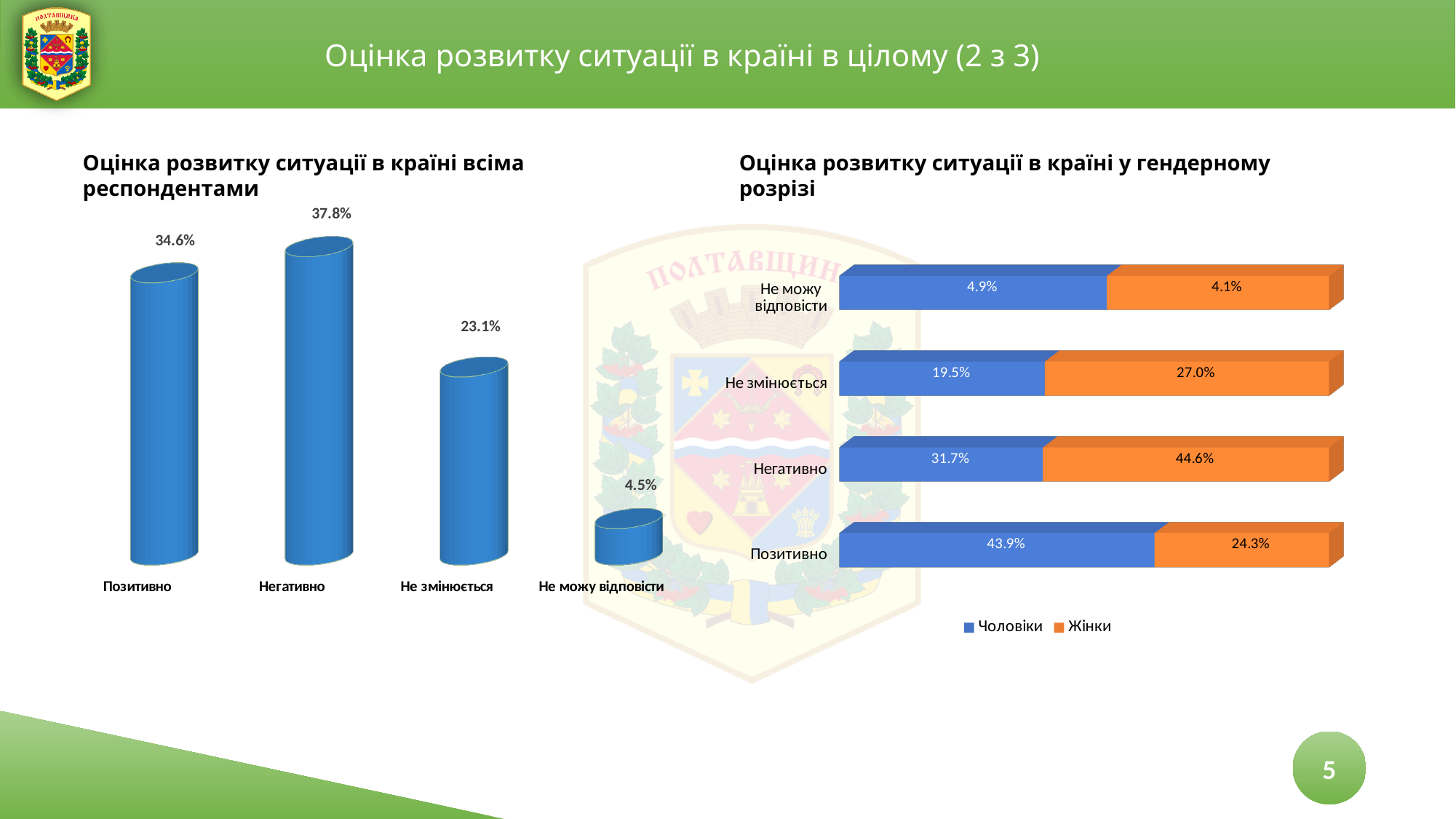
In the right chart (Оцінка розвитку ситуації в країні у гендерному розрізі), which is larger for Не змінюється: Чоловіки or Жінки? Жінки In the left chart (Оцінка розвитку ситуації в країні всіма респондентами), how many categories are shown? 4 What kind of chart is the left chart (Оцінка розвитку ситуації в країні всіма респондентами)? Bar chart In the left chart (Оцінка розвитку ситуації в країні всіма респондентами), what is the difference between Негативно and Позитивно? 3.2% In the right chart (Оцінка розвитку ситуації в країні у гендерному розрізі), what is the value for Жінки in the Негативно category? 44.6% In the left chart (Оцінка розвитку ситуації в країні всіма респондентами), what is the value for Негативно? 37.8% In the right chart (Оцінка розвитку ситуації в країні у гендерному розрізі), how many series does the legend list? 2 In the left chart (Оцінка розвитку ситуації в країні всіма респондентами), which category has the lowest value? Не можу відповісти In the left chart (Оцінка розвитку ситуації в країні всіма респондентами), which category has the highest value? Негативно In the right chart (Оцінка розвитку ситуації в країні у гендерному розрізі), what is the total of the stacked bar for Позитивно? 68.2% In the right chart (Оцінка розвитку ситуації в країні у гендерному розрізі), what colour represents Жінки? Orange In the right chart (Оцінка розвитку ситуації в країні у гендерному розрізі), what is the value for Чоловіки in the Позитивно category? 43.9%